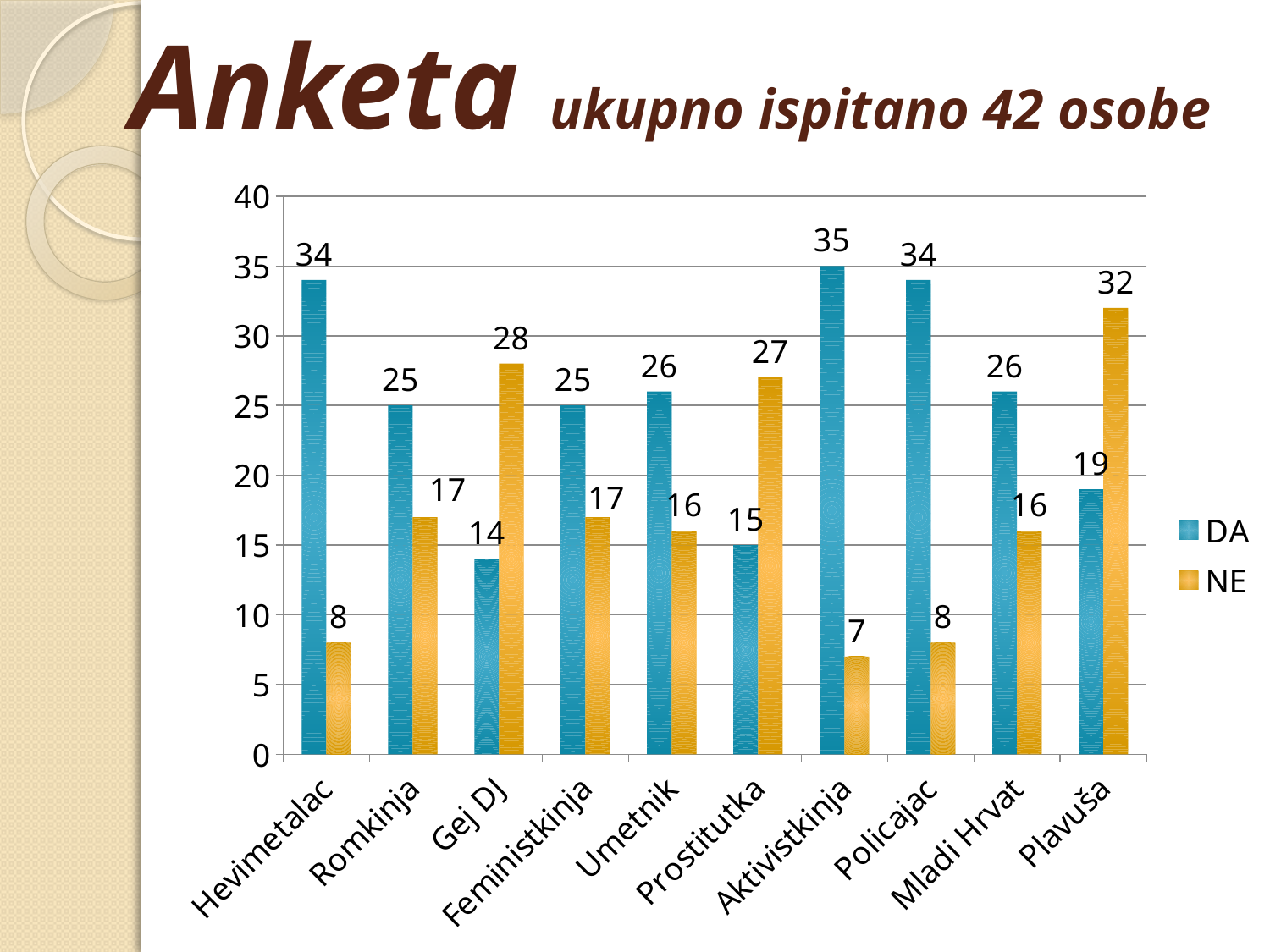
What is the NE value for Gej DJ? 28 What are the two series named in the legend? DA and NE How many categories are shown on the x axis? 10 What is the difference between the DA and NE values for Hevimetalac? 26 What kind of chart is shown on the slide? Bar chart Which is larger for Prostitutka, the DA value or the NE value? NE Which category has the highest NE value? Plavuša Which category has the highest DA value? Aktivistkinja What is the DA value for Plavuša? 19 How many series does the legend list? 2 Which category has the lowest NE value? Aktivistkinja What is the DA value for Aktivistkinja? 35